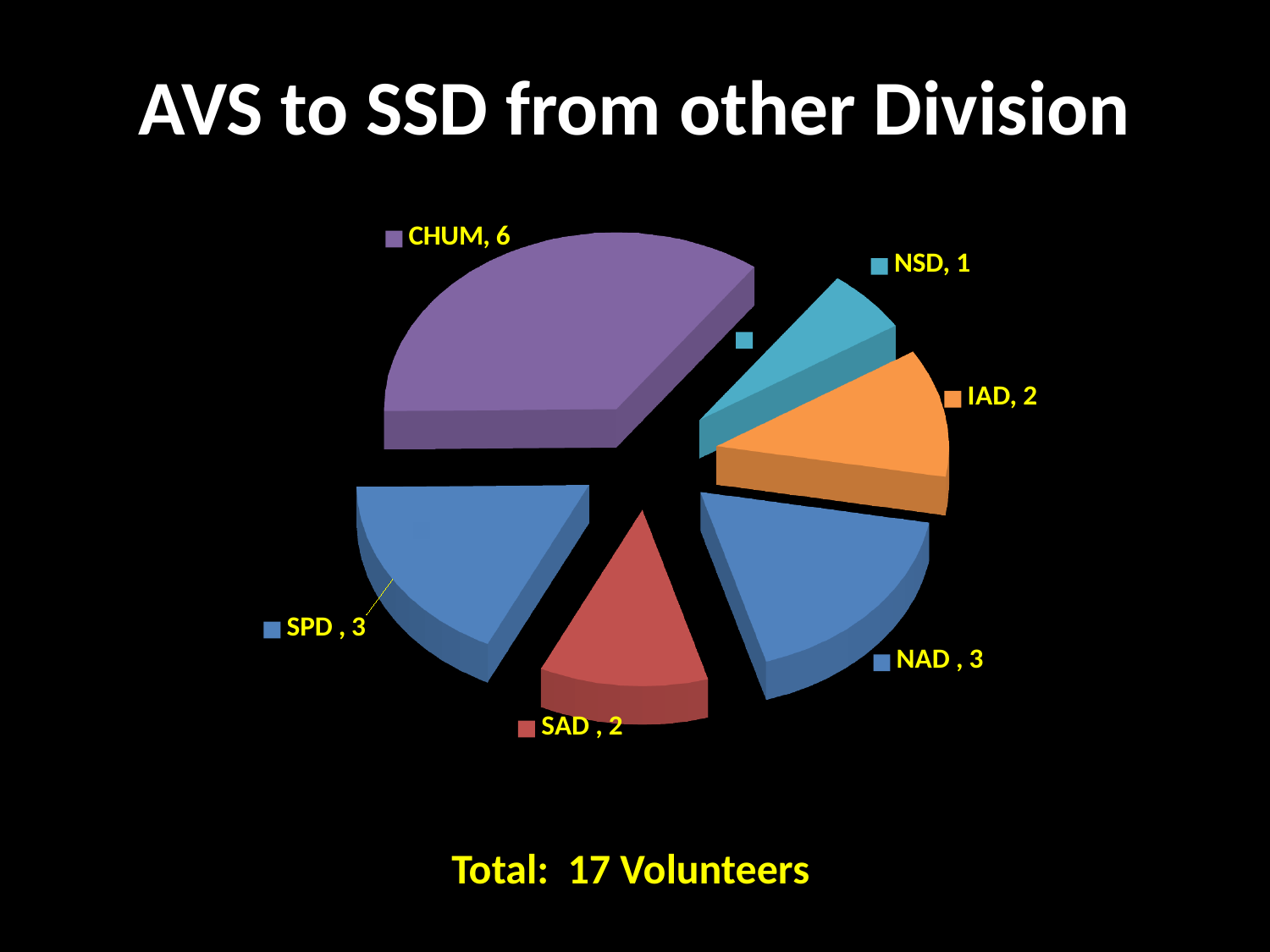
What type of chart is shown on the slide? pie chart What is the value for NSD? 1 Which division has the smallest slice of the pie? NSD How many divisions (slices) are shown in the pie chart? 6 What is the difference between the values for CHUM and NAD? 3 What is the value for IAD? 2 What is the value for NAD? 3 Which is larger, the value for SPD or the value for SAD? SPD What is the title of the slide? AVS to SSD from other Division Which division has the largest slice of the pie? CHUM What is the total number of volunteers shown on the slide? 17 What is the value for CHUM? 6